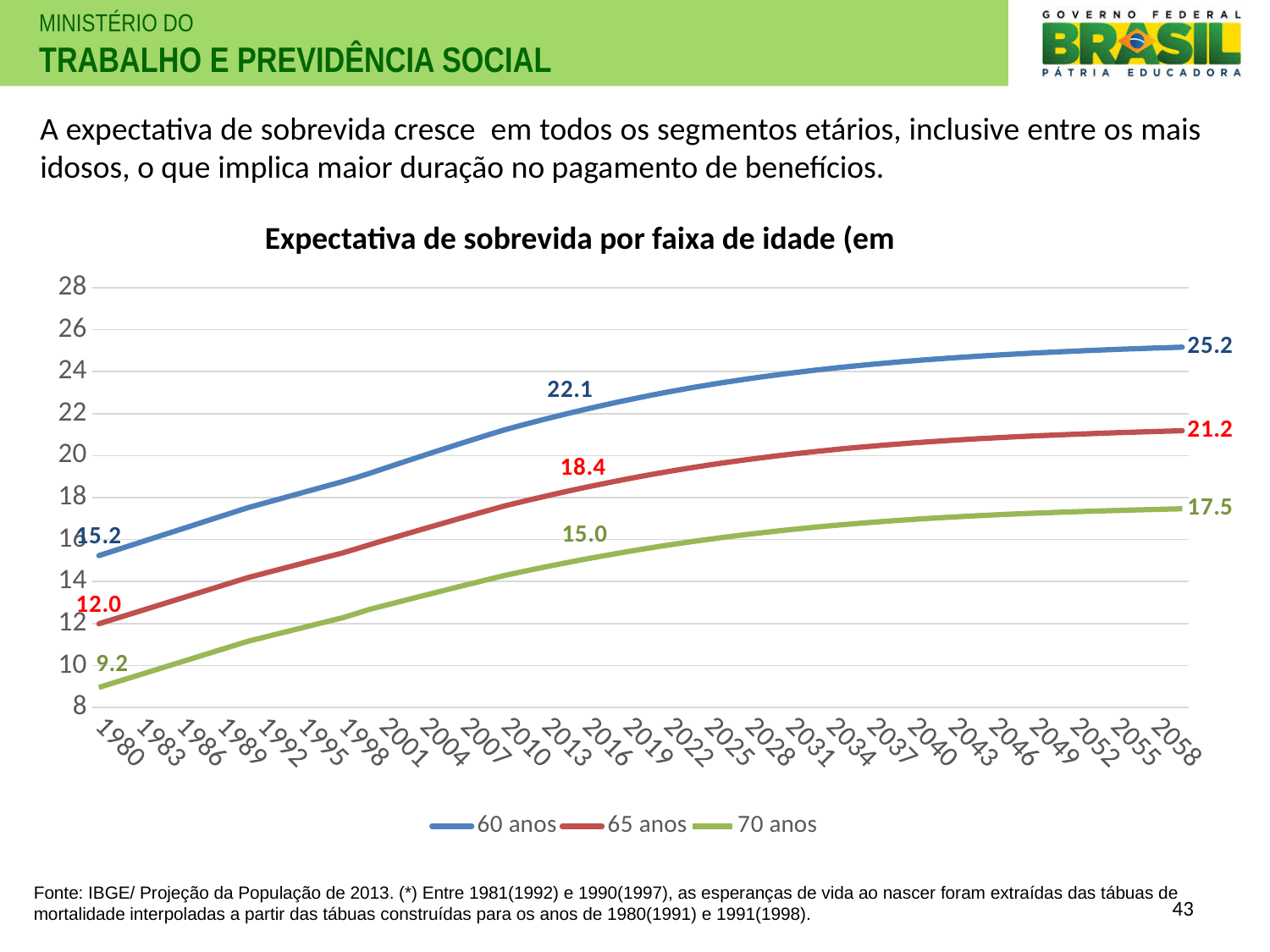
What is the difference between the 60 anos value in 2058 and its value in 1980? 10.0 What is the value for the 60 anos series in 2058? 25.2 What is the value for the 65 anos series in 2058? 21.2 What is the value for the 70 anos series in 2058? 17.5 What is the value for the 60 anos series in 1980? 15.2 What is the value for the 70 anos series in 1980? 9.2 What is the value for the 65 anos series in 1980? 12.0 What kind of chart is shown on the slide? line chart Which series has the highest value in 2058? 60 anos How many series does the legend list? 3 Is the value for the 65 anos series in 2040 greater or less than 20? greater Do the values of the 70 anos series rise or fall from 1980 to 2058? rise